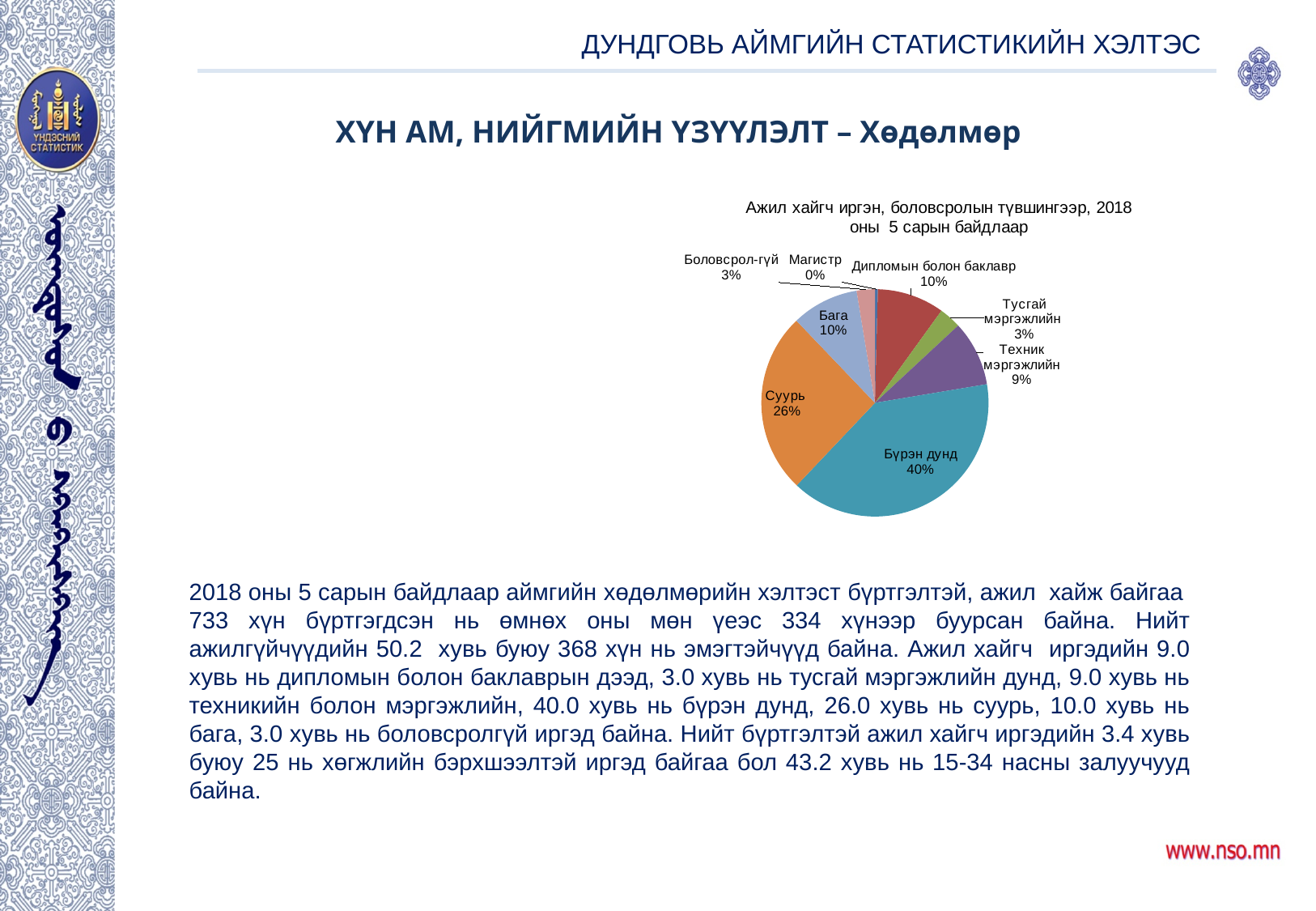
How many categories are shown in the pie chart? 8 What share of the pie does Бүрэн дунд hold? 40% What percentage is shown for Техник мэргэжлийн? 9% What percentage is shown for Магистр? 0% What is the title of the chart? Ажил хайгч иргэн, боловсролын түвшингээр, 2018 оны 5 сарын байдлаар What share of the pie does Суурь hold? 26% What percentage is shown for Дипломын болон баклавр? 10% Which category has the largest slice of the pie? Бүрэн дунд Which category has the smallest slice of the pie? Магистр Which is larger, the share for Бага or the share for Техник мэргэжлийн? Бага What is the difference in percentage points between Бүрэн дунд and Суурь? 14 What type of chart is shown on the slide? Pie chart